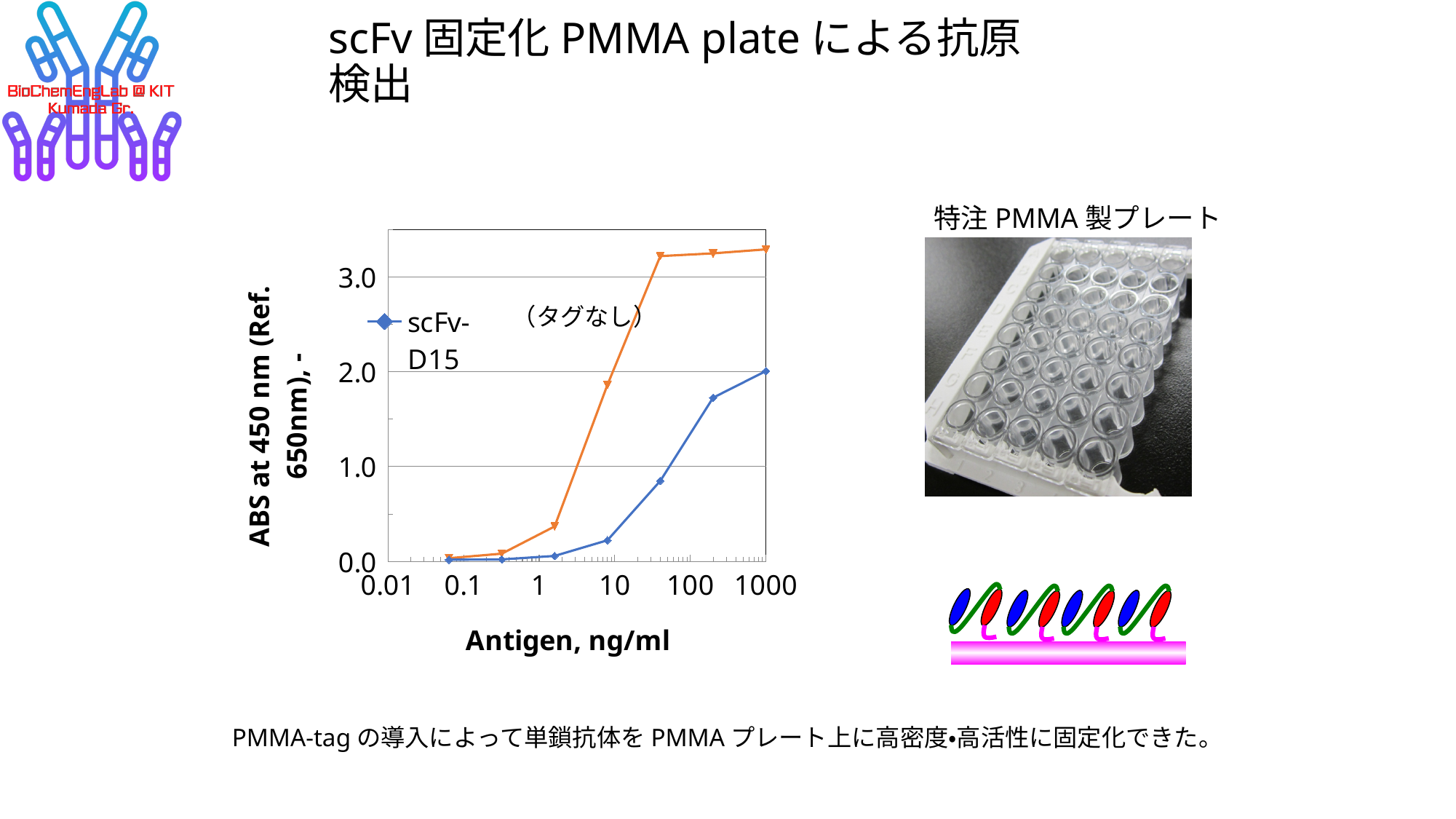
Does the absorbance for scFv-D15 rise or fall as the antigen concentration increases? rise Is the scFv-D15 value at about 10 ng/ml antigen greater or less than 1.0? less How many lines are plotted on the chart? 2 What kind of chart is shown on the slide? line chart Which series reaches the highest absorbance on the chart, the orange series or scFv-D15? the orange series How many data points does the scFv-D15 series have? 7 At about 10 ng/ml antigen, which line is higher, the orange series or scFv-D15? the orange series Is the orange series value at about 10 ng/ml antigen greater or less than 2.0? less What is the title of the x axis of the chart? Antigen, ng/ml Is the orange series value at 1000 ng/ml antigen greater or less than 3.0? greater Which series name is listed in the chart's legend? scFv-D15